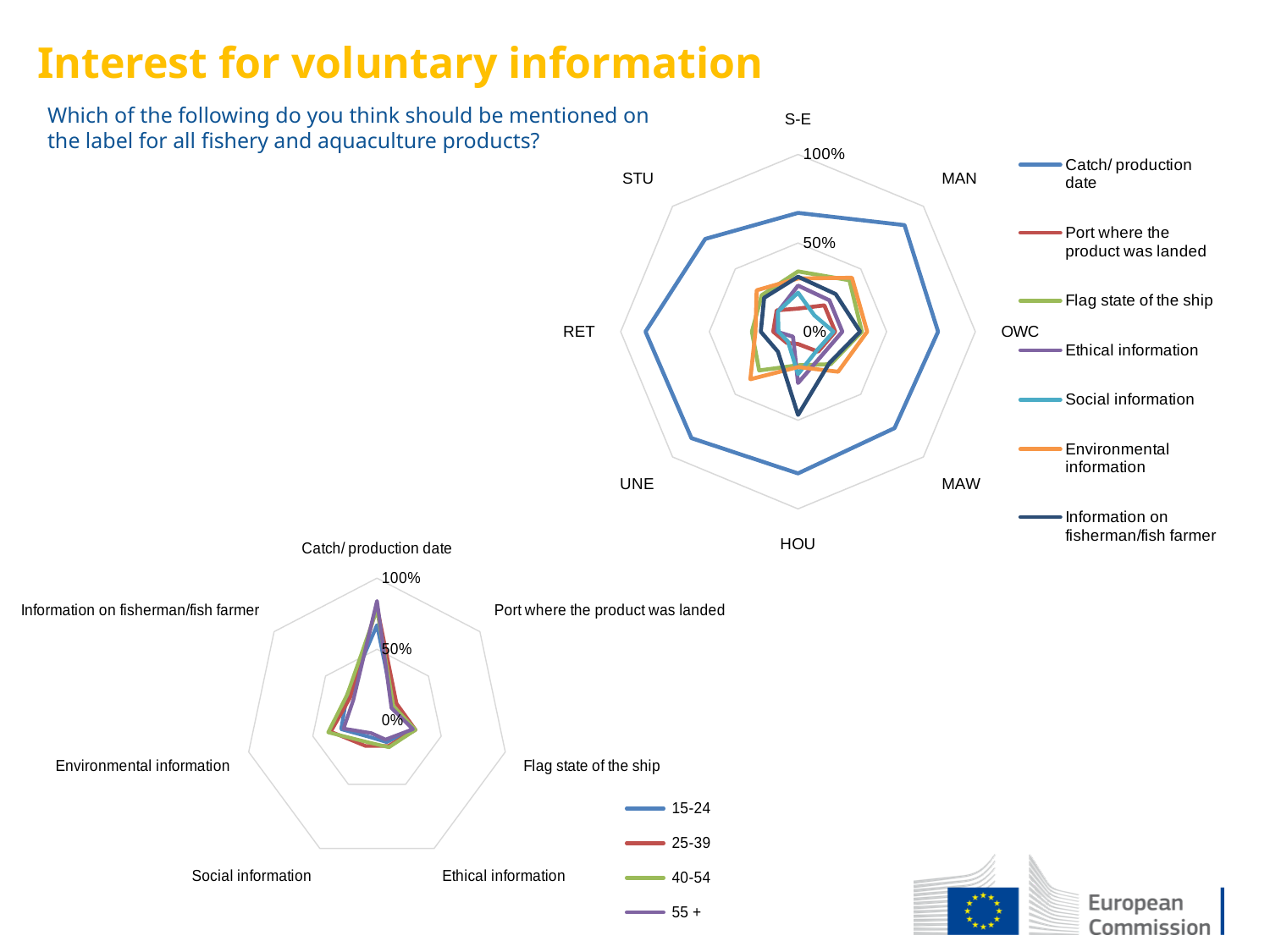
In the bottom-left radar chart, is the value for the 55 + group at Catch/ production date greater or less than 50%? greater In the top-right radar chart, which is larger at RET: Catch/ production date or Ethical information? Catch/ production date In the top-right radar chart, which series has the highest values across all categories? Catch/ production date In the top-right radar chart, is the value for Social information at HOU greater or less than 50%? less How many series does the legend of the bottom-left radar chart list? 4 What is the title of the slide containing the two radar charts? Interest for voluntary information In the bottom-left radar chart, which category has the highest value for the 55 + group? Catch/ production date How many series does the legend of the top-right radar chart list? 7 What kind of chart is the chart in the top right of the slide? Radar chart How many categories (axes) does the top-right radar chart have? 8 In the top-right radar chart, is the value for Catch/ production date at S-E greater or less than 50%? greater How many categories (axes) does the bottom-left radar chart have? 7